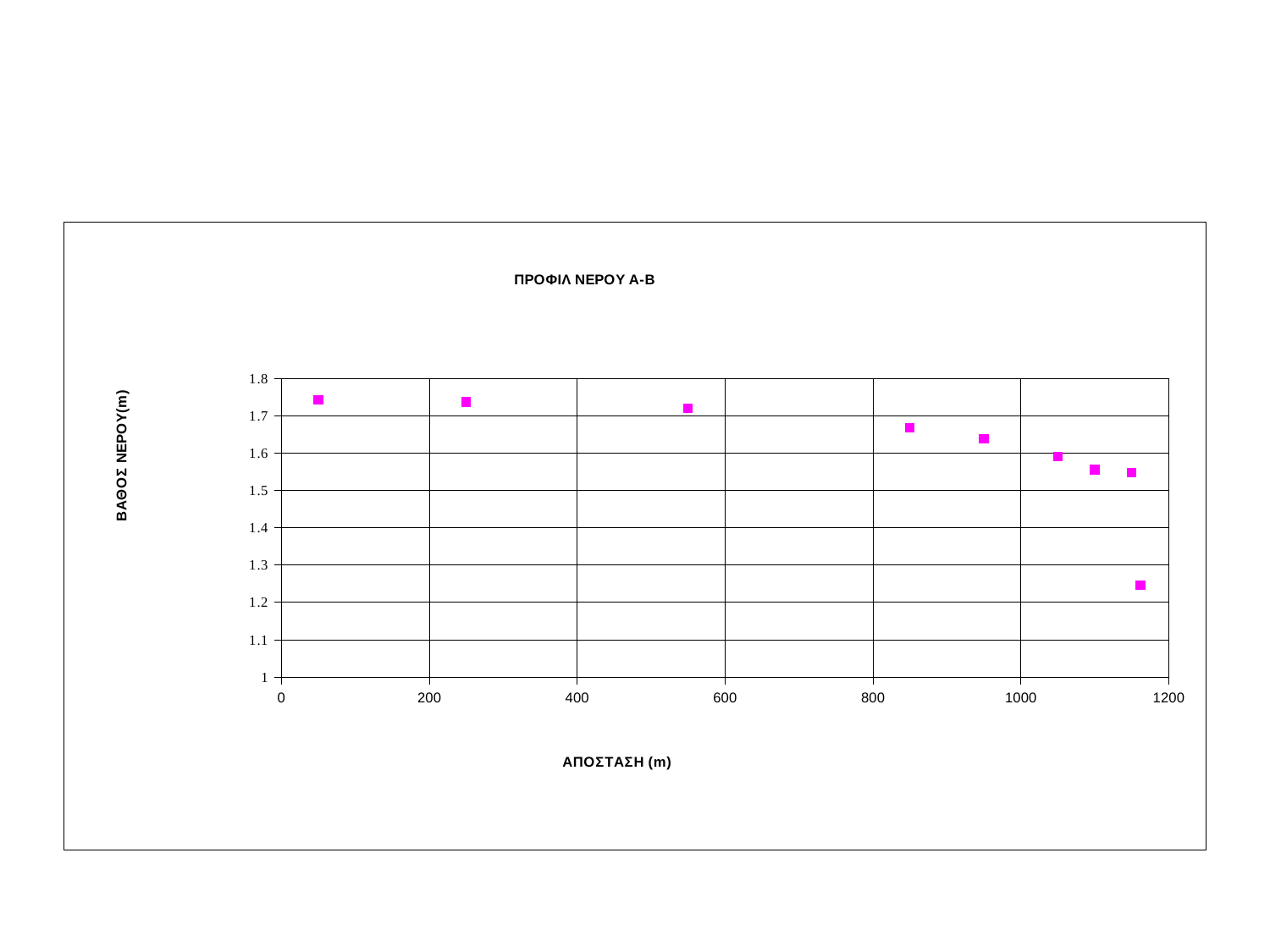
Which has the larger water depth value: the point near 550 m or the point near 950 m? the point near 550 m What is the title of the chart? ΠΡΟΦΙΛ ΝΕΡΟΥ Α-Β What is the label of the x axis? ΑΠΟΣΤΑΣΗ (m) Is the value of the point near 950 m greater or less than 1.6? greater Is the value of the point near 850 m greater or less than 1.7? less Is the value of the point near 1100 m greater or less than 1.6? less How many data points are plotted on the chart? 9 Is the lowest plotted point the leftmost or the rightmost point on the chart? rightmost Do the plotted water depth values generally rise or fall as distance increases along the x axis? fall What kind of chart is shown on the slide? scatter chart